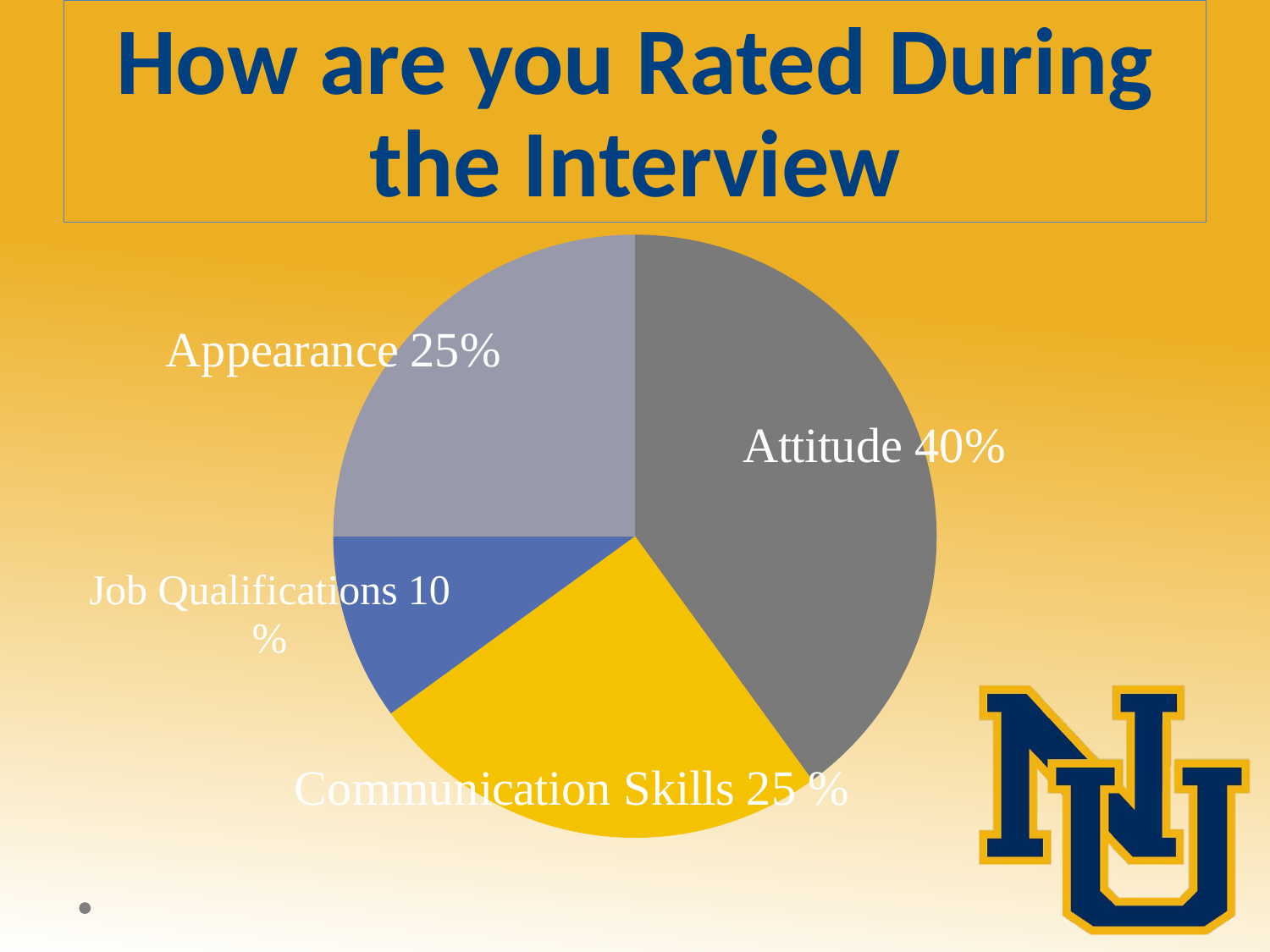
What is the difference between the Attitude and Job Qualifications percentages? 30% Which category has the smallest share of the pie? Job Qualifications What percentage is shown for Communication Skills? 25% What percentage is shown for Job Qualifications? 10% What is the title of the slide containing the pie chart? How are you Rated During the Interview What colour is the Communication Skills slice? Yellow What kind of chart is shown on the slide? Pie chart How many categories are shown in the pie chart? 4 What percentage is shown for Attitude? 40% Which is larger, the share for Attitude or the share for Appearance? Attitude What percentage is shown for Appearance? 25% Which category has the largest share of the pie? Attitude